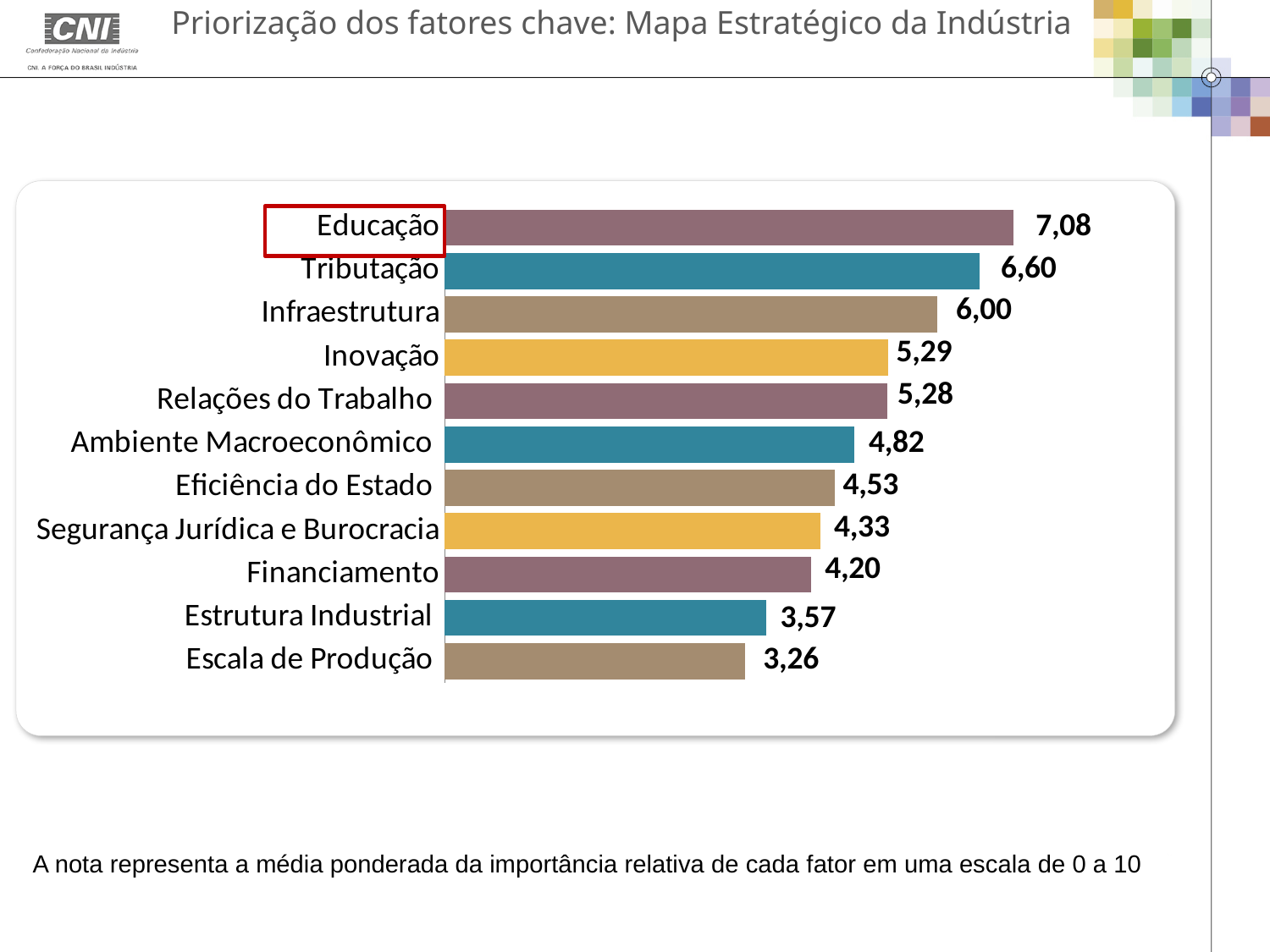
What is the value for Ambiente Macroeconômico? 4,82 Do the values increase or decrease from the top bar to the bottom bar? Decrease What kind of chart is shown on the slide? Bar chart What is the difference between the values for Educação and Tributação? 0,48 What is the value for Escala de Produção? 3,26 What is the value for Educação? 7,08 Which has a larger value, Financiamento or Estrutura Industrial? Financiamento What is the difference between the values for Infraestrutura and Escala de Produção? 2,74 What is the value for Segurança Jurídica e Burocracia? 4,33 How many categories are shown in the chart? 11 Which category has the highest value? Educação Which category has the lowest value? Escala de Produção